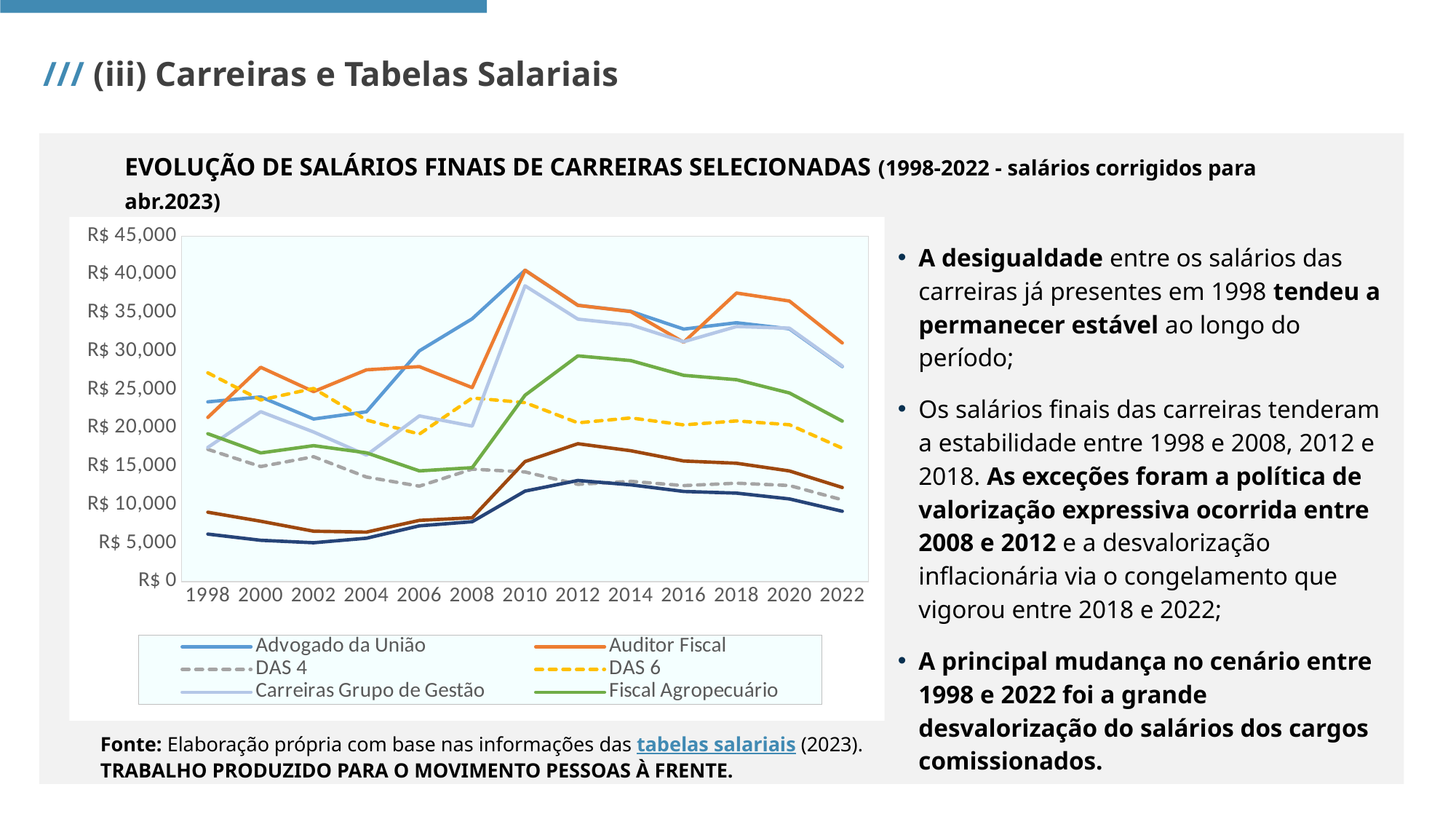
Which legend series has the highest value in 2022? Auditor Fiscal Does the DAS 6 line rise or fall overall from 1998 to 2022? Fall In 1998, which is larger: DAS 6 or Advogado da União? DAS 6 Which two legend series are drawn with dashed lines? DAS 4 and DAS 6 Is the value for Fiscal Agropecuário in 2012 greater or less than R$ 25,000? greater How many series does the chart legend list? 6 Is the value for DAS 4 in 2006 greater or less than R$ 15,000? less Is the value for DAS 6 in 2022 greater or less than R$ 20,000? less How many years are labelled along the x axis of the chart? 13 In 2010, which is larger: Auditor Fiscal or Fiscal Agropecuário? Auditor Fiscal What kind of chart is shown on the slide? Line chart